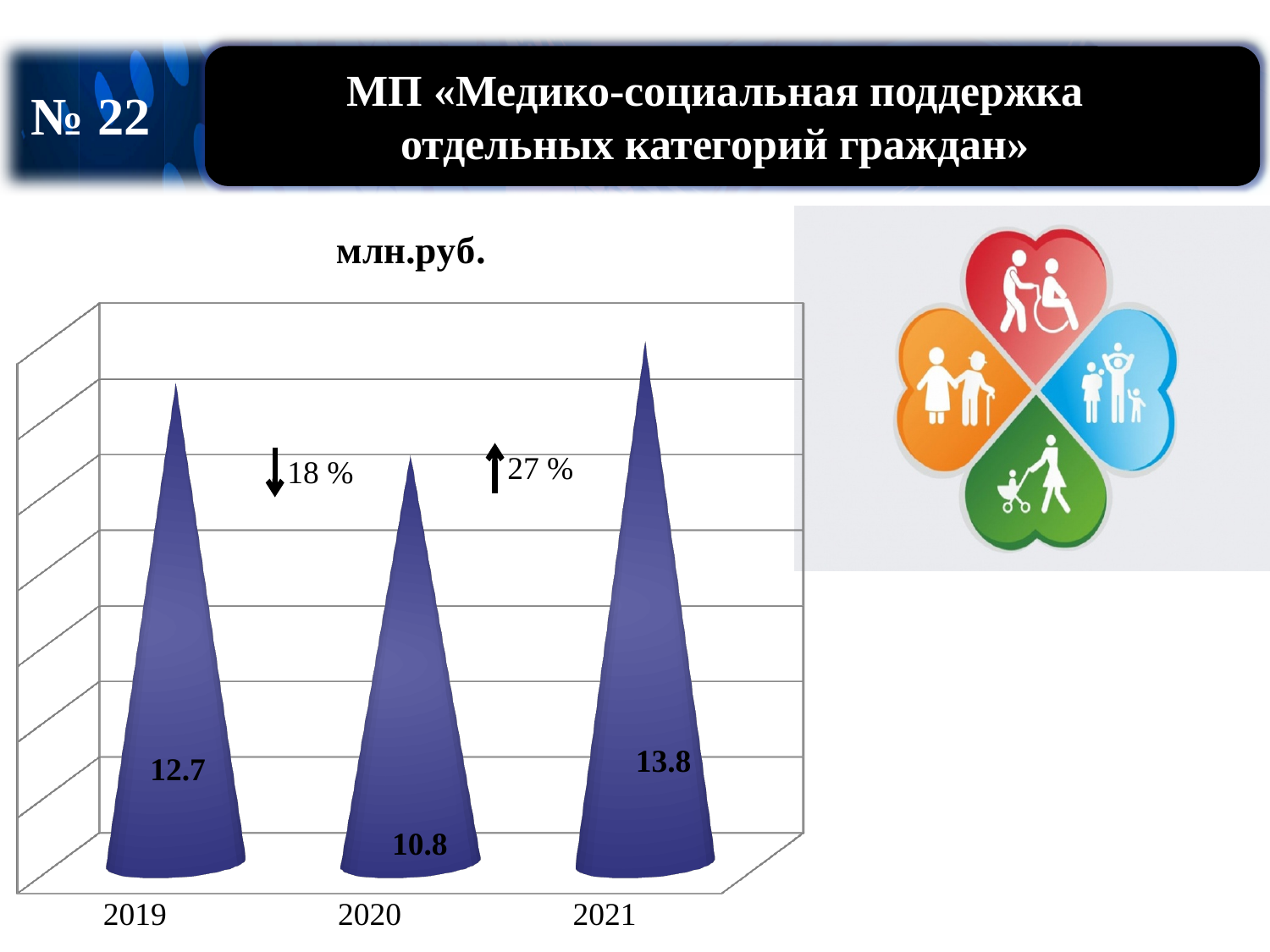
Which is larger, the value for 2019 or the value for 2021? 2021 What is the difference between the values for 2019 and 2020? 1.9 What is the value for 2019? 12.7 What percentage change is annotated between 2020 and 2021? 27 % What is the difference between the values for 2021 and 2020? 3.0 How many years are shown on the chart? 3 Which year has the lowest value? 2020 What is the value for 2021? 13.8 Which year has the highest value? 2021 What is the value for 2020? 10.8 What kind of chart is shown on the slide? bar chart What unit is shown above the chart? млн.руб.